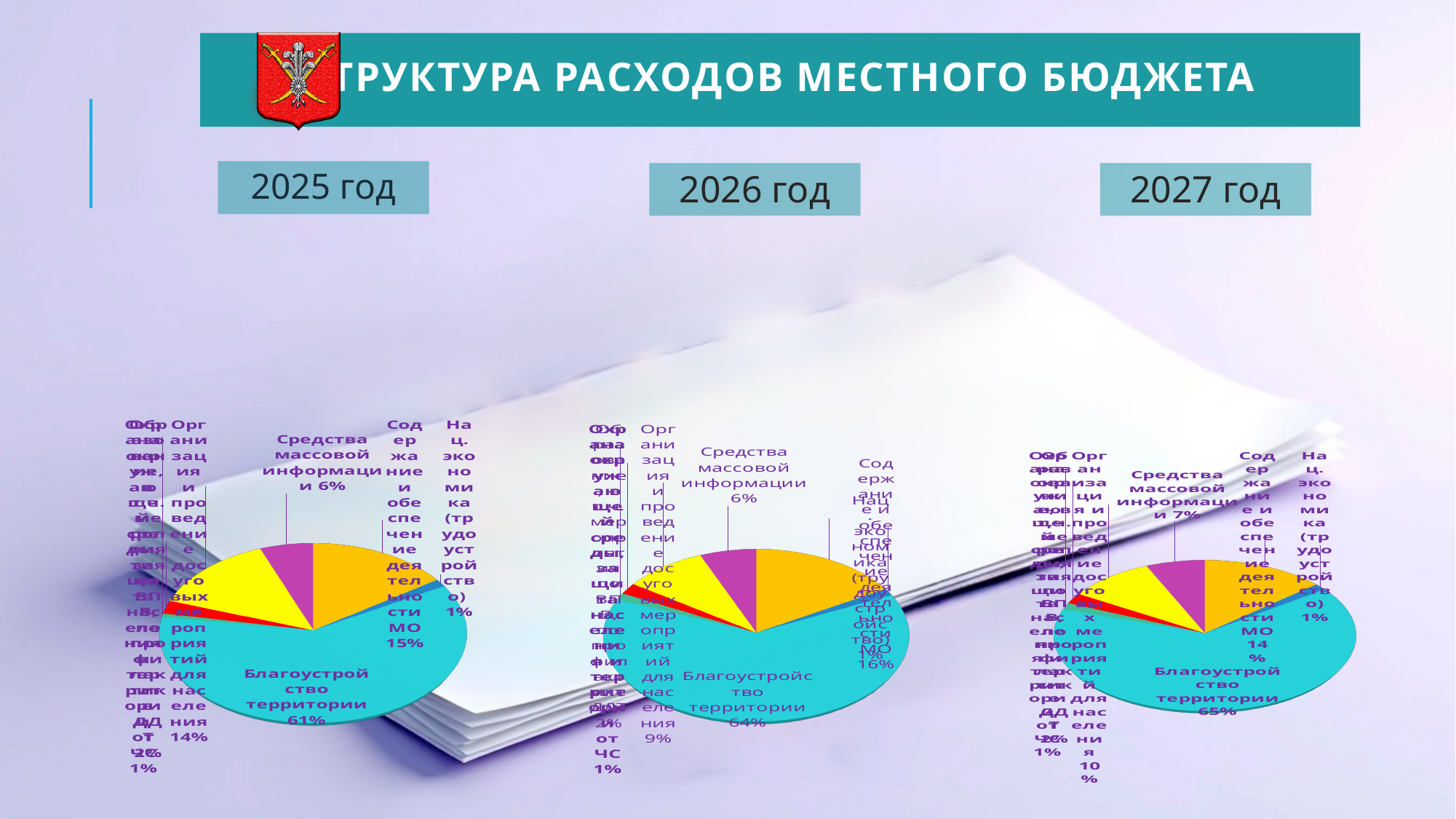
In the 2025 год chart, what share is Благоустройство территории? 61% What kind of charts are shown on the slide? Pie charts Does the share of Благоустройство территории rise or fall from the 2025 год chart to the 2027 год chart? Rises In the 2027 год chart, what share is Средства массовой информации? 7% In the 2027 год chart, what share is Благоустройство территории? 65% In the 2026 год chart, what share is Благоустройство территории? 64% In the 2025 год chart, what share is Средства массовой информации? 6% In the 2026 год chart, which category has the largest share? Благоустройство территории How much larger is the Благоустройство территории share in the 2027 год chart than in the 2025 год chart? 4% How many pie charts are on the slide? 3 What is the title of the slide? СТРУКТУРА РАСХОДОВ МЕСТНОГО БЮДЖЕТА In the 2027 год chart, what share is Содержание и обеспечение деятельности МО? 14%